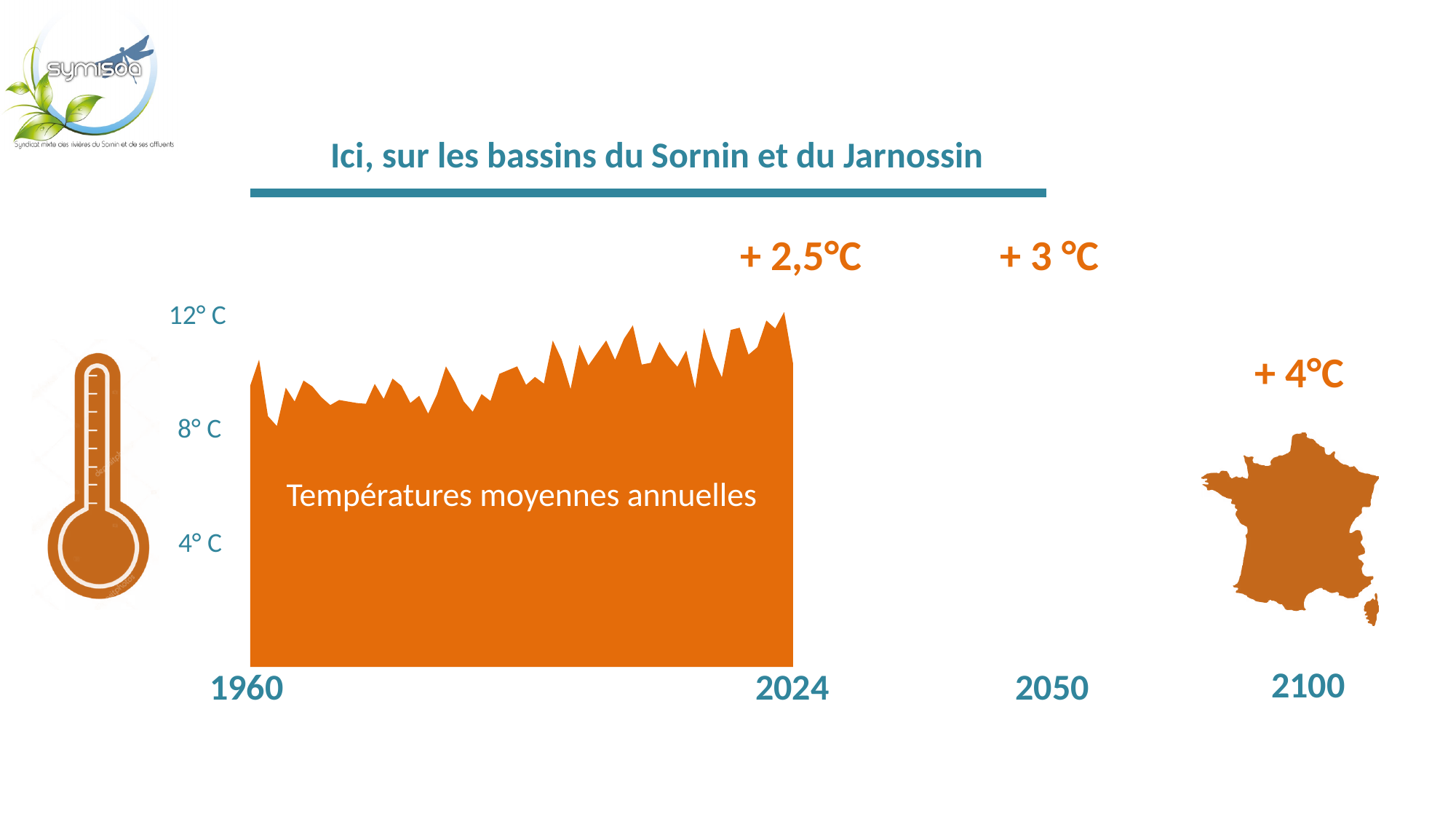
What is the first year shown on the x axis of the chart? 1960 What temperature increase is annotated for 2100? + 4°C What series label is written inside the orange area of the chart? Températures moyennes annuelles What is the last year of plotted data on the chart? 2024 What temperature increase is annotated above the chart for 2024? + 2,5°C Is the value for 1960 greater or less than 4° C? greater What kind of chart is shown on the slide? Area chart Is the value for 2024 greater or less than 8° C? greater What is the title above the chart? Ici, sur les bassins du Sornin et du Jarnossin Do the annual mean temperatures rise or fall from 1960 to 2024 along the x axis? Rise What temperature increase is annotated for 2050? + 3 °C